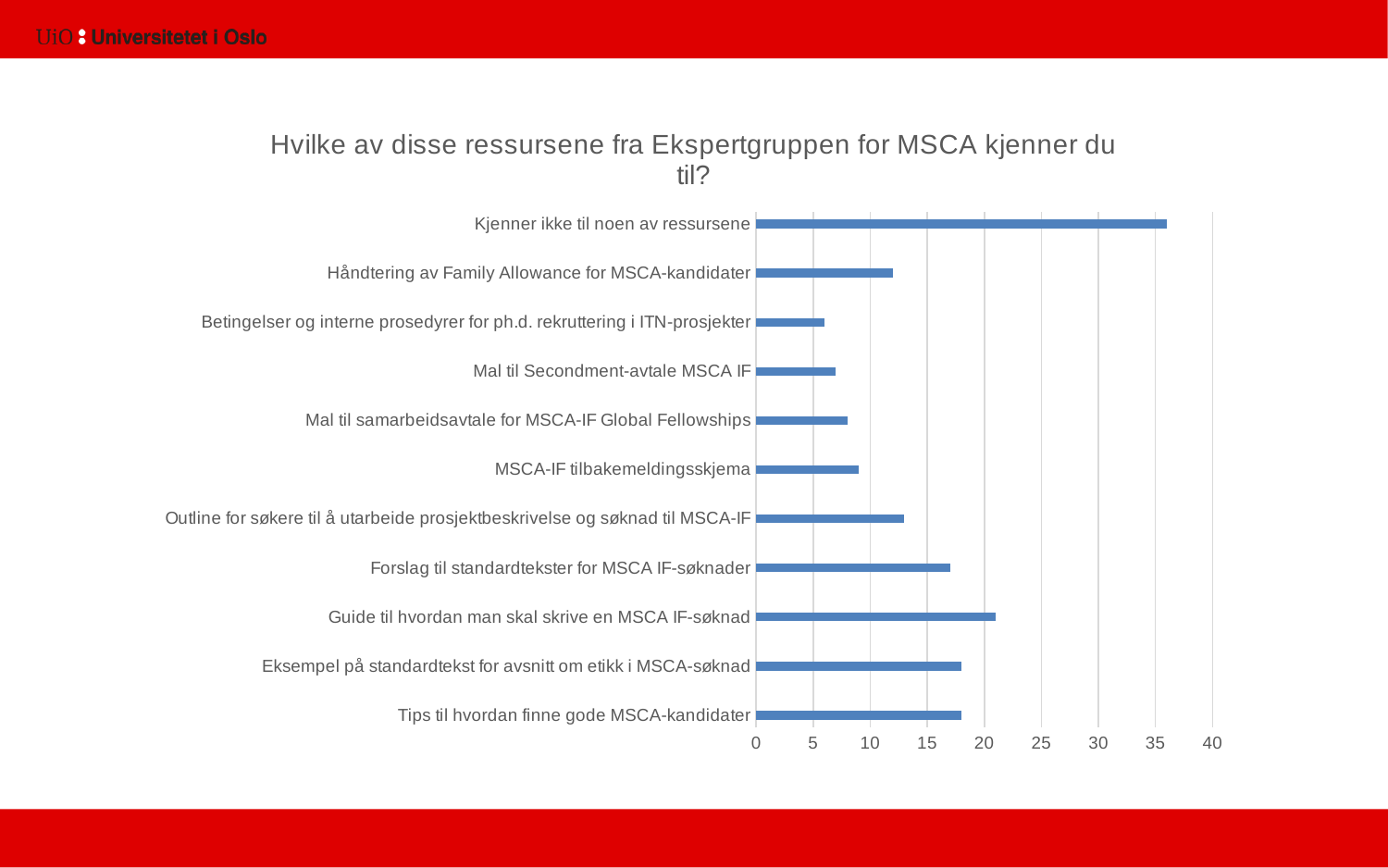
What kind of chart is shown on the slide? bar chart Is the value for "Outline for søkere til å utarbeide prosjektbeskrivelse og søknad til MSCA-IF" greater or less than 15? less Is the value for "Betingelser og interne prosedyrer for ph.d. rekruttering i ITN-prosjekter" greater or less than 10? less Is the value for "Eksempel på standardtekst for avsnitt om etikk i MSCA-søknad" greater or less than 20? less Which is larger: the value for "Tips til hvordan finne gode MSCA-kandidater" or for "Mal til Secondment-avtale MSCA IF"? Tips til hvordan finne gode MSCA-kandidater How many categories (resources) are plotted in the chart? 11 Which category has the highest value in the chart? Kjenner ikke til noen av ressursene Which is larger: the value for "Guide til hvordan man skal skrive en MSCA IF-søknad" or for "Forslag til standardtekster for MSCA IF-søknader"? Guide til hvordan man skal skrive en MSCA IF-søknad What is the title of the chart? Hvilke av disse ressursene fra Ekspertgruppen for MSCA kjenner du til?